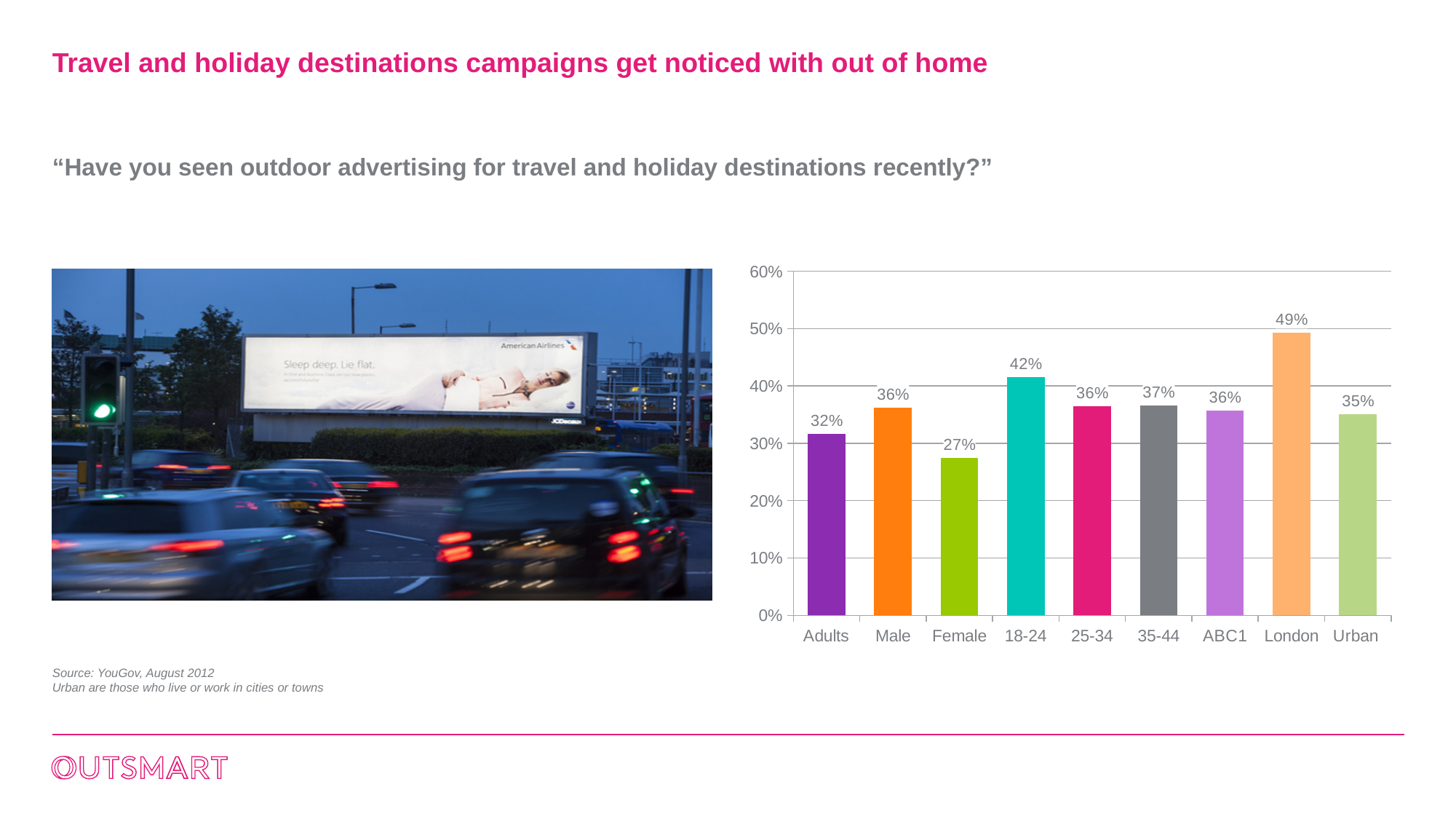
What kind of chart is shown on the slide? Bar chart Which category has the highest value in the chart? London What is the difference between the values for Male and Female? 9% What is the value shown for London? 49% What percentage of Adults said they had seen outdoor advertising for travel and holiday destinations recently? 32% Which category has the lowest value in the chart? Female Which is larger, the value for 18-24 or the value for 25-34? 18-24 What is the value shown for Female respondents? 27% What is the difference between the values for London and Adults? 17% Is the value for Urban greater or less than 40%? less How many categories are shown on the x axis of the chart? 9 What is the value shown for the 18-24 age group? 42%